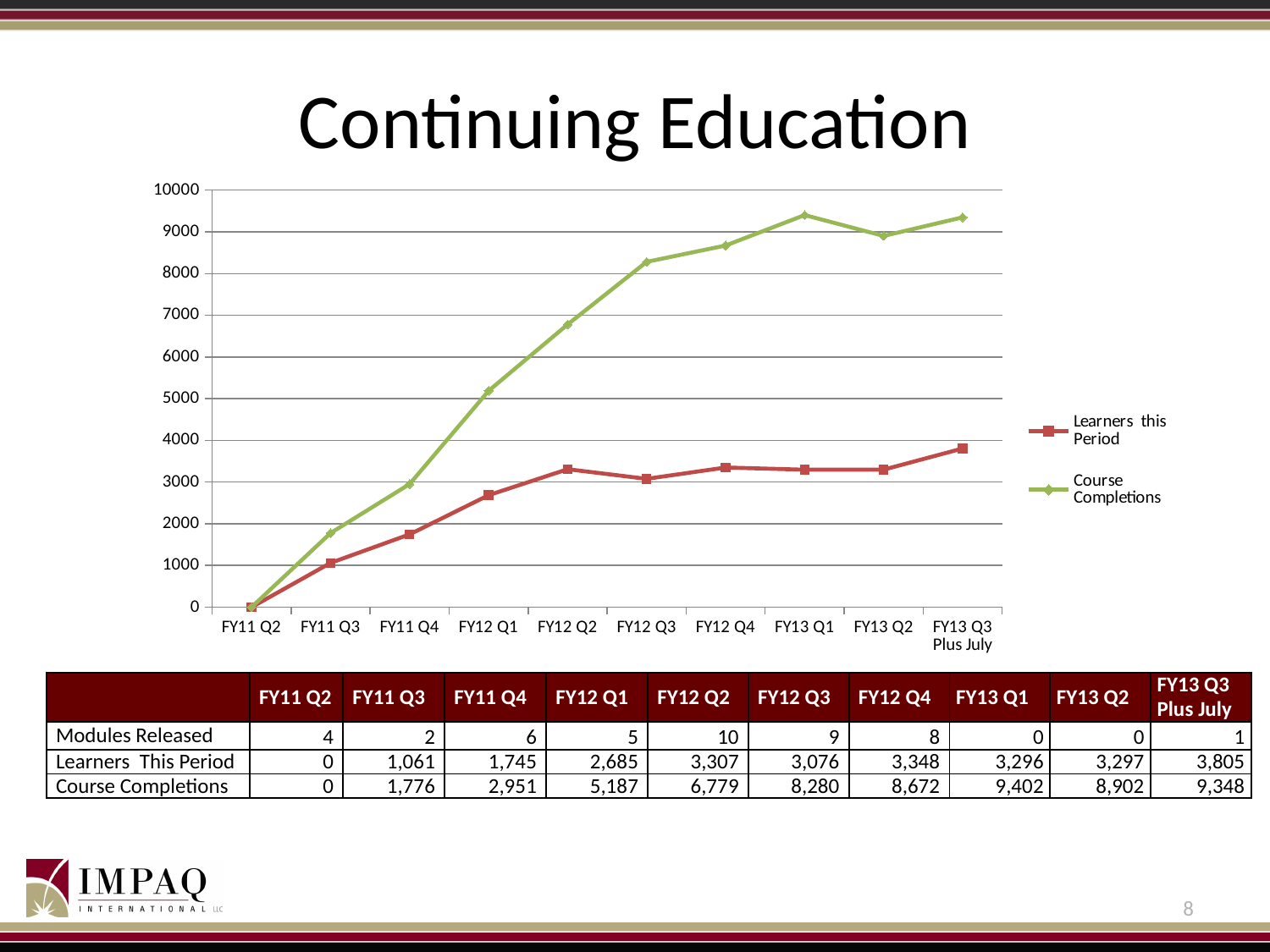
In which quarter is Learners This Period highest? FY13 Q3 Plus July What is the value of Learners This Period for FY12 Q2? 3,307 Is the value of Learners This Period for FY12 Q1 greater or less than 3000? less By how much did Course Completions fall from FY13 Q1 to FY13 Q2? 500 How many quarters (categories) are plotted along the x axis of the chart? 10 Does the Course Completions line rise or fall from FY11 Q2 to FY12 Q4? Rise In which quarter is Course Completions highest? FY13 Q1 How many series does the chart's legend list? 2 What is the value of Course Completions for FY12 Q3? 8,280 Which is larger: Course Completions in FY13 Q1 or in FY13 Q2? FY13 Q1 What kind of chart is shown on the slide? Line chart What is the difference between Course Completions and Learners This Period in FY12 Q2? 3,472